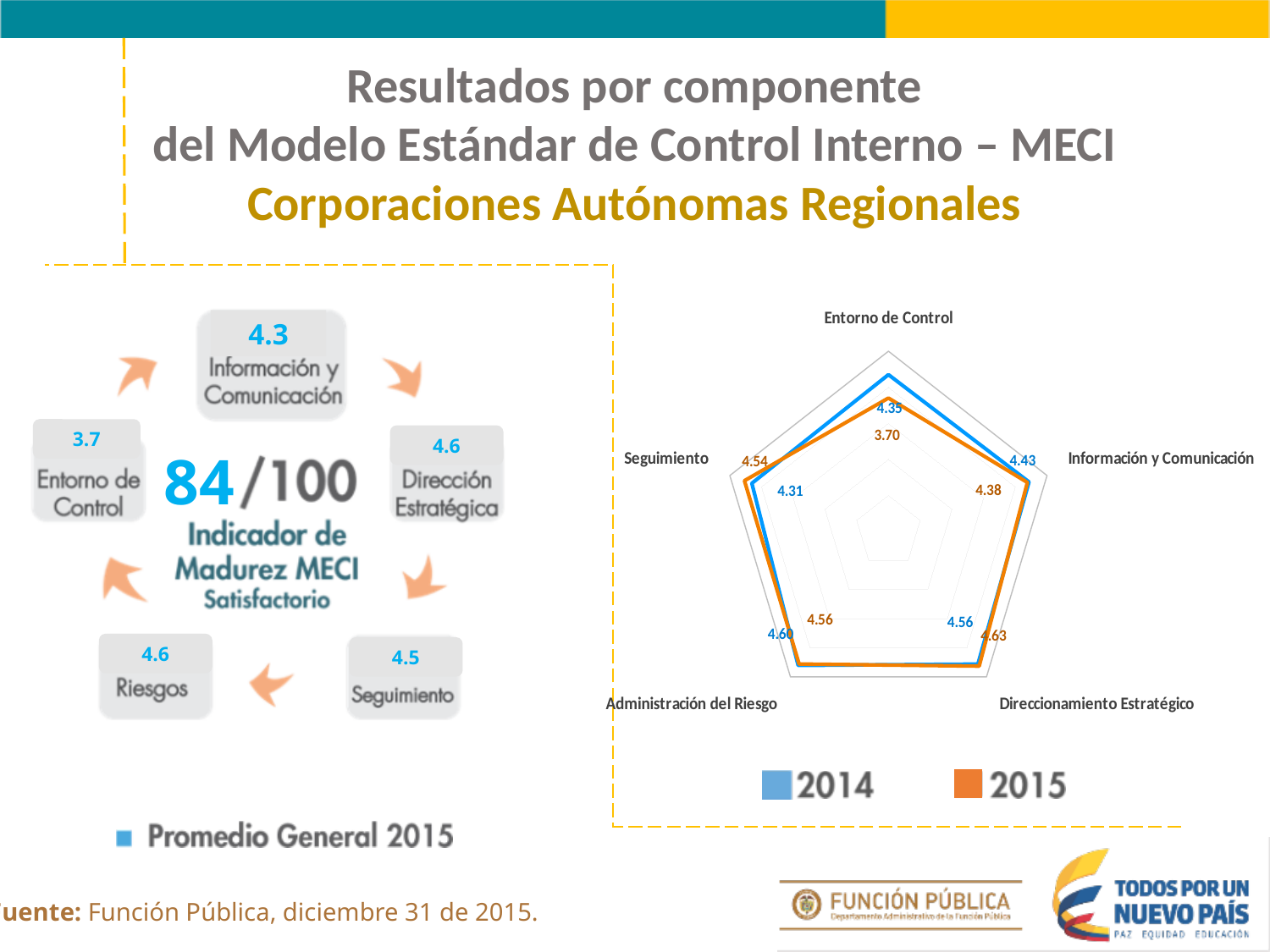
In the radar chart, what is the 2015 value for Entorno de Control? 3.70 In the radar chart, is the 2014 value for Entorno de Control larger or smaller than the 2015 value? Larger How many series does the legend of the radar chart list? 2 Which two years are listed in the legend of the radar chart? 2014 and 2015 In the radar chart, which component has the lowest 2015 value? Entorno de Control In the radar chart, what is the 2014 value for Entorno de Control? 4.35 In the radar chart, what is the 2015 value for Seguimiento? 4.54 In the radar chart, what is the difference between the 2014 and 2015 values for Entorno de Control? 0.65 In the radar chart, what is the 2014 value for Información y Comunicación? 4.43 In the radar chart, what is the 2015 value for Direccionamiento Estratégico? 4.63 How many components (axes) does the radar chart have? 5 What kind of chart is shown on the right side of the slide? Radar chart